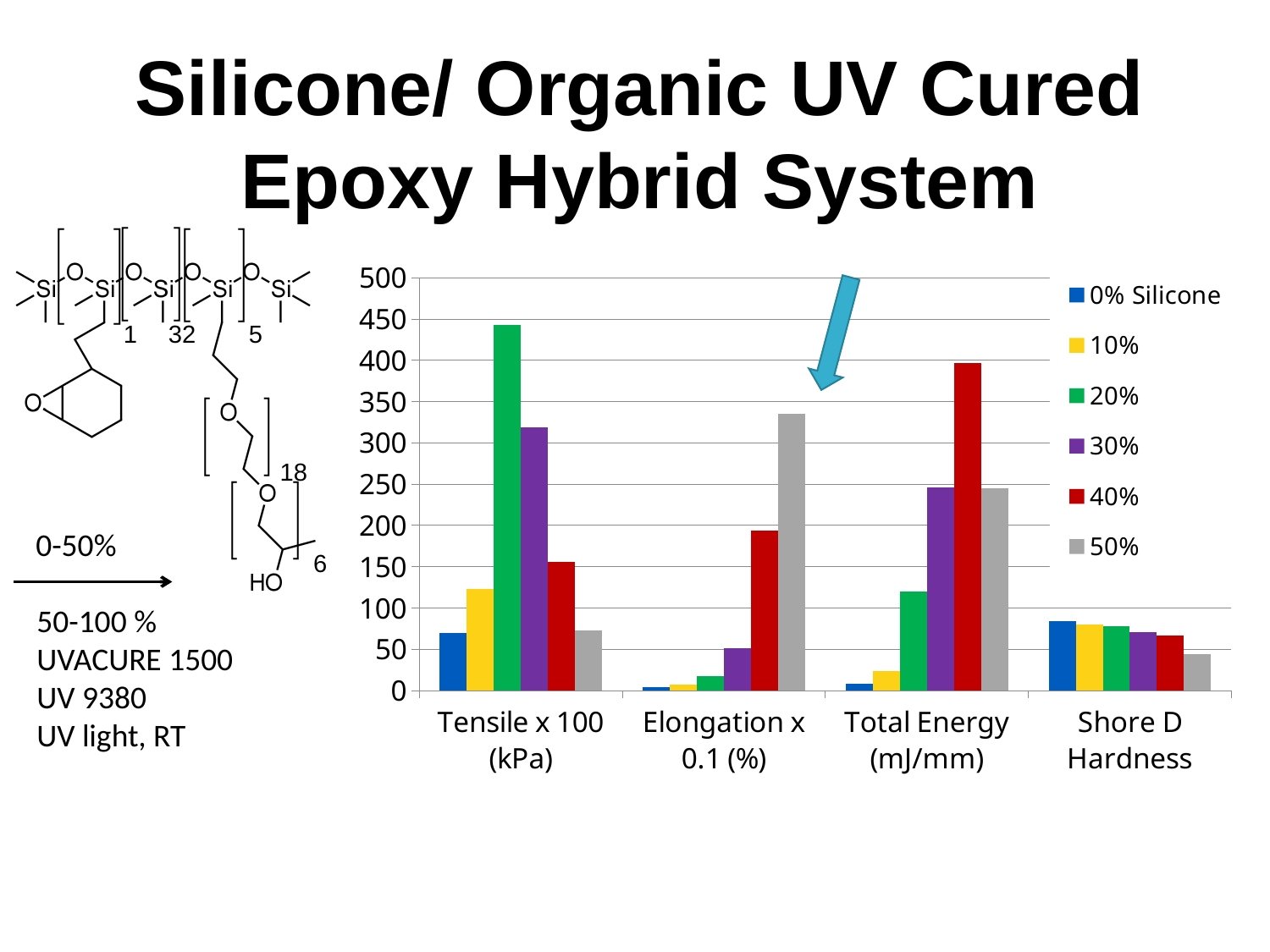
Which silicone level has the highest Tensile x 100 (kPa) value? 20% How many property categories are shown along the x axis? 4 What is the first entry listed in the legend? 0% Silicone For Total Energy (mJ/mm), which is larger: the 30% or the 40% silicone value? 40% Which silicone level has the highest Total Energy (mJ/mm) value? 40% How many series does the legend list? 6 Which silicone level has the lowest Shore D Hardness? 50% Is the Elongation x 0.1 (%) value for 50% silicone greater or less than 300? greater Which silicone level has the highest Elongation x 0.1 (%) value? 50% Is the Tensile x 100 (kPa) value for 20% silicone greater or less than 400? greater What kind of chart is shown on the slide? bar chart As silicone content increases from 0% to 50%, does Shore D Hardness rise or fall? fall